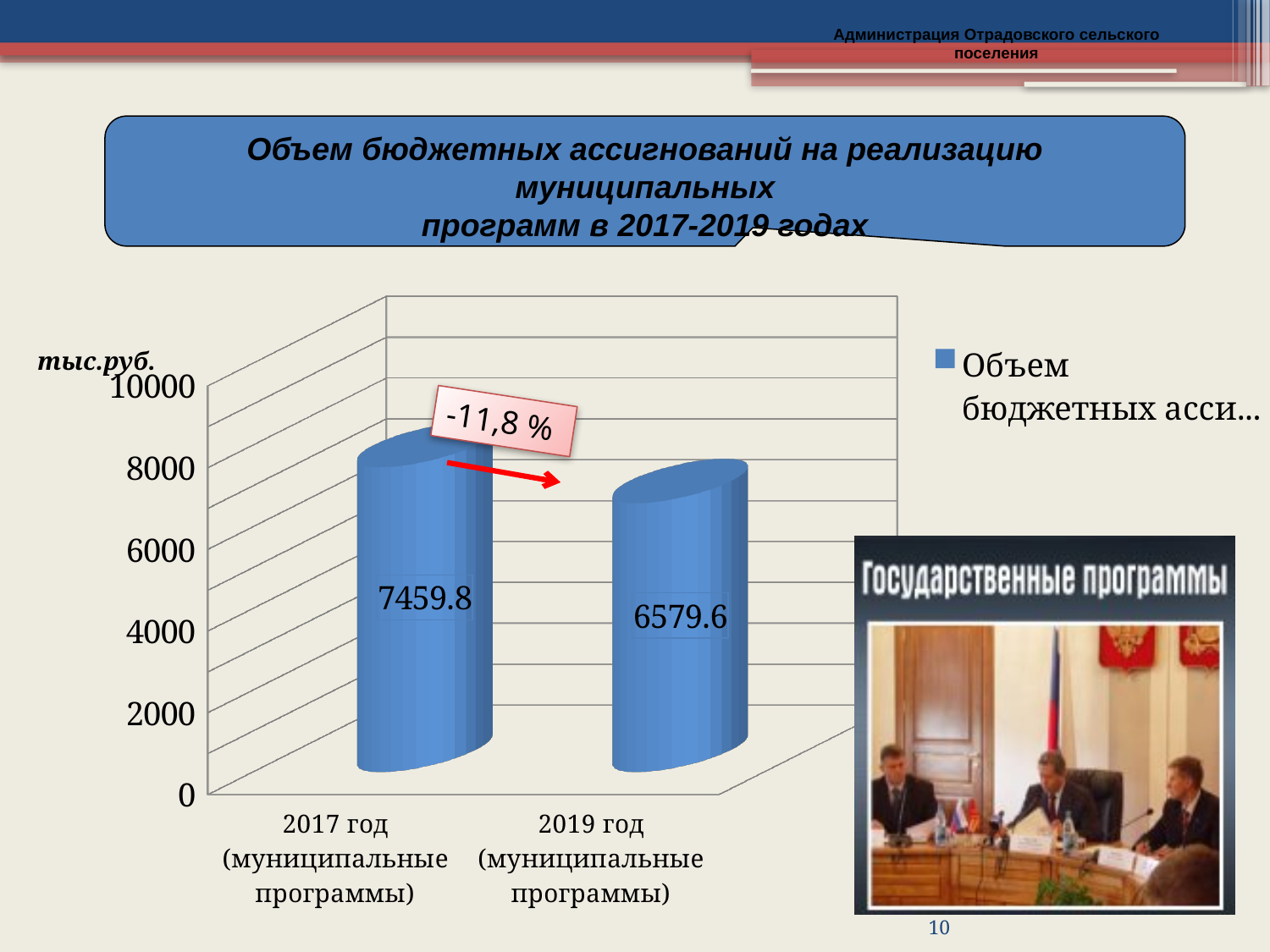
Is the value for 2017 год larger or smaller than the value for 2019 год? larger What percentage change is shown in the annotation between the two bars? -11,8 % Is the value for 2019 год greater or less than 8000? less Which year has the higher value? 2017 год How many categories are shown on the chart? 2 What kind of chart is shown? bar chart Do the values rise or fall from 2017 to 2019? fall What is the value for 2017 год (муниципальные программы)? 7459.8 What is the difference between the 2017 and 2019 values? 880.2 What is the value for 2019 год (муниципальные программы)? 6579.6 Is the value for 2017 год greater or less than 6000? greater Which year has the lower value? 2019 год